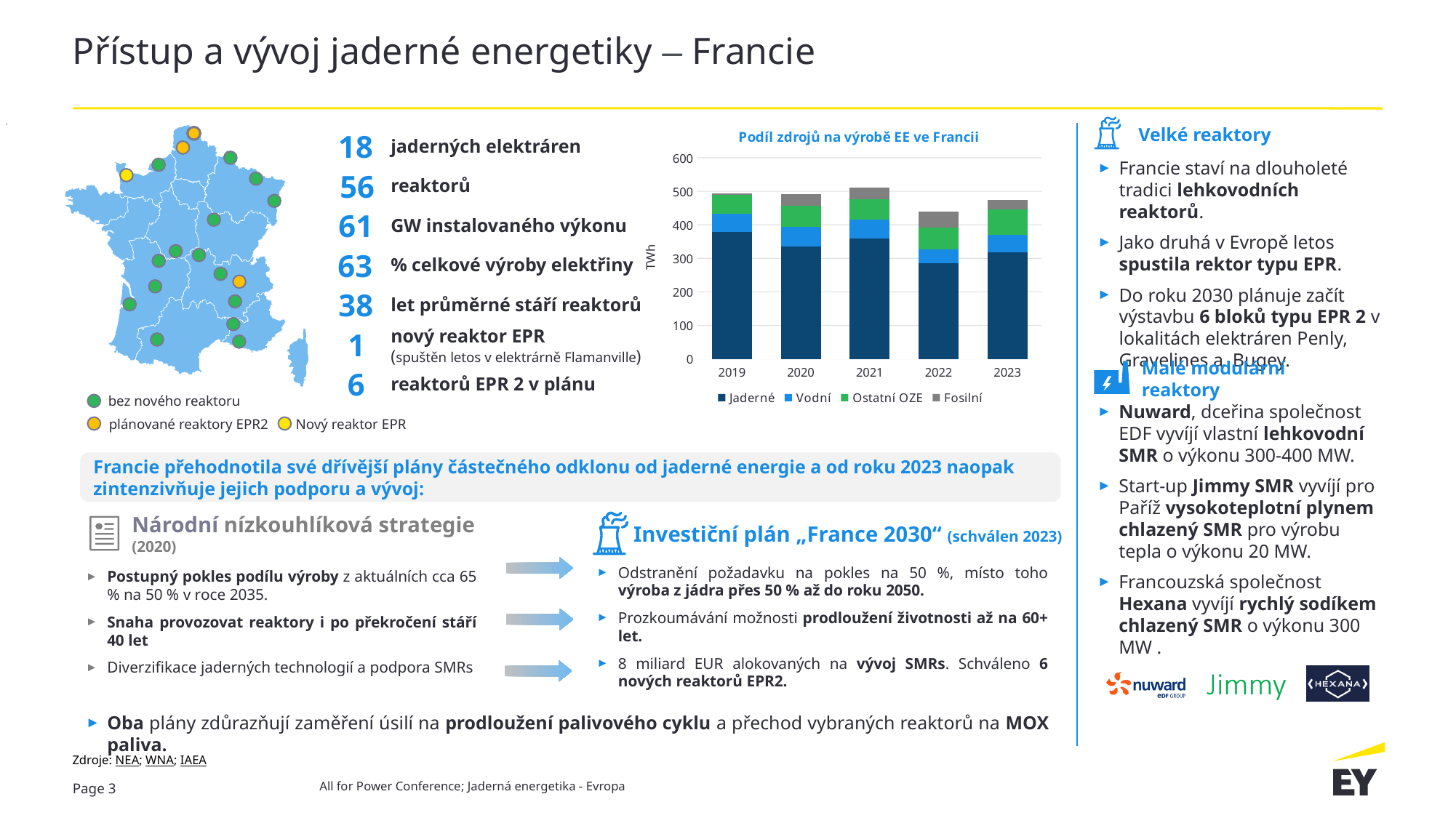
In the chart "Podíl zdrojů na výrobě EE ve Francii", is the Jaderné value for 2019 greater or less than 300? greater In the chart "Podíl zdrojů na výrobě EE ve Francii", in which year is the Jaderné segment the smallest? 2022 How many series does the legend of the chart "Podíl zdrojů na výrobě EE ve Francii" list? 4 How many years are shown on the x axis of the chart "Podíl zdrojů na výrobě EE ve Francii"? 5 In the chart "Podíl zdrojů na výrobě EE ve Francii", which year has the lowest total bar? 2022 In the chart "Podíl zdrojů na výrobě EE ve Francii", is the total bar for 2022 greater or less than 500? less In the chart "Podíl zdrojů na výrobě EE ve Francii", which year has the highest total bar? 2021 What kind of chart is "Podíl zdrojů na výrobě EE ve Francii"? Stacked bar chart What unit is shown on the y axis of the chart "Podíl zdrojů na výrobě EE ve Francii"? TWh In the chart "Podíl zdrojů na výrobě EE ve Francii", is the Jaderné value for 2022 greater or less than 300? less Which series is listed first in the legend of the chart "Podíl zdrojů na výrobě EE ve Francii"? Jaderné In the chart "Podíl zdrojů na výrobě EE ve Francii", is the Jaderné segment larger in 2019 or in 2022? 2019